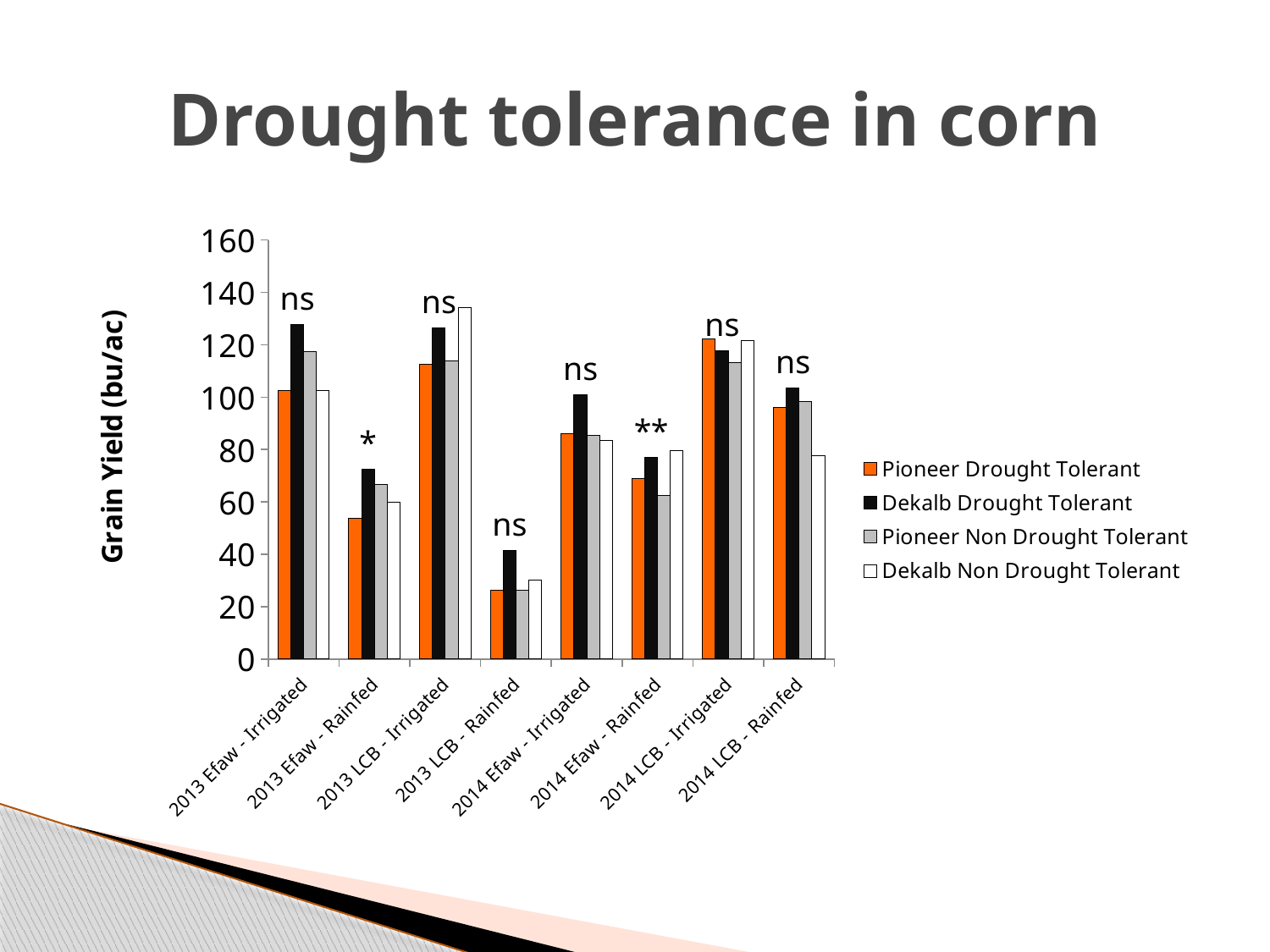
What annotation is printed above the bars for 2014 Efaw - Rainfed? ** Which category has the lowest Pioneer Drought Tolerant value? 2013 LCB - Rainfed At 2014 LCB - Rainfed, which is larger: Pioneer Non Drought Tolerant or Dekalb Non Drought Tolerant? Pioneer Non Drought Tolerant At 2013 Efaw - Rainfed, which is larger: Dekalb Drought Tolerant or Pioneer Drought Tolerant? Dekalb Drought Tolerant What is the title of the y axis? Grain Yield (bu/ac) What kind of chart is shown on the slide? bar chart Is the value for Dekalb Non Drought Tolerant at 2013 LCB - Irrigated greater or less than 120? greater How many series does the legend list? 4 How many categories are shown along the x axis? 8 Is the value for Pioneer Drought Tolerant at 2014 LCB - Rainfed greater or less than 80? greater Which category has the highest Dekalb Non Drought Tolerant value? 2013 LCB - Irrigated Is the value for Dekalb Drought Tolerant at 2013 LCB - Rainfed greater or less than 60? less